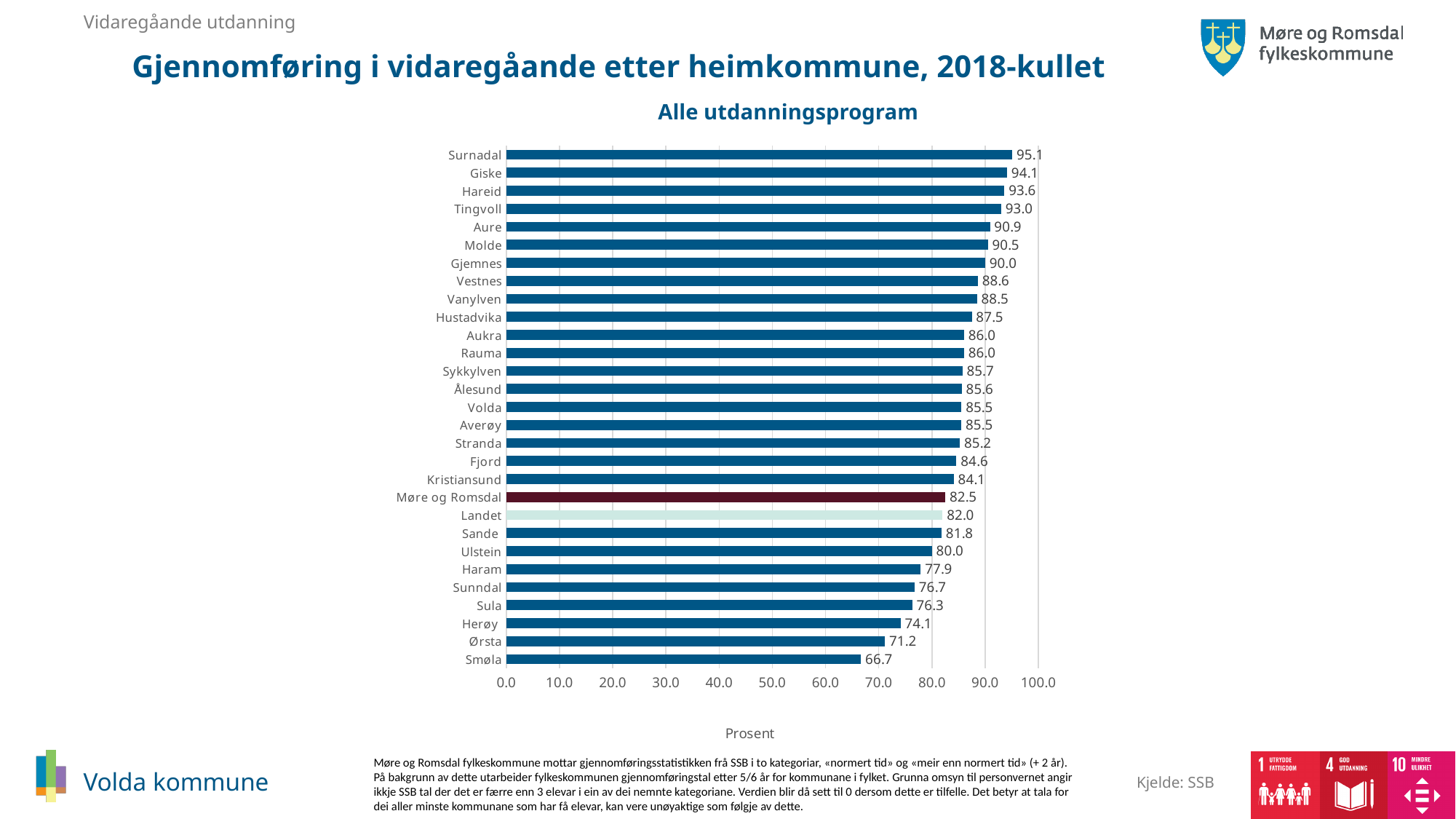
What is the value for Landet? 82.0 What is the title of the chart? Alle utdanningsprogram How many categories are shown in the chart? 29 Which category has the lowest value? Smøla What is the value for Møre og Romsdal? 82.5 What is the difference between the values for Surnadal and Smøla? 28.4 What is the difference between the values for Volda and Landet? 3.5 Which has a larger value, Ørsta or Herøy? Herøy What kind of chart is shown on the slide? bar chart Is the value for Ulstein greater or less than 90.0? less What is the value for Volda? 85.5 Which category has the highest value? Surnadal